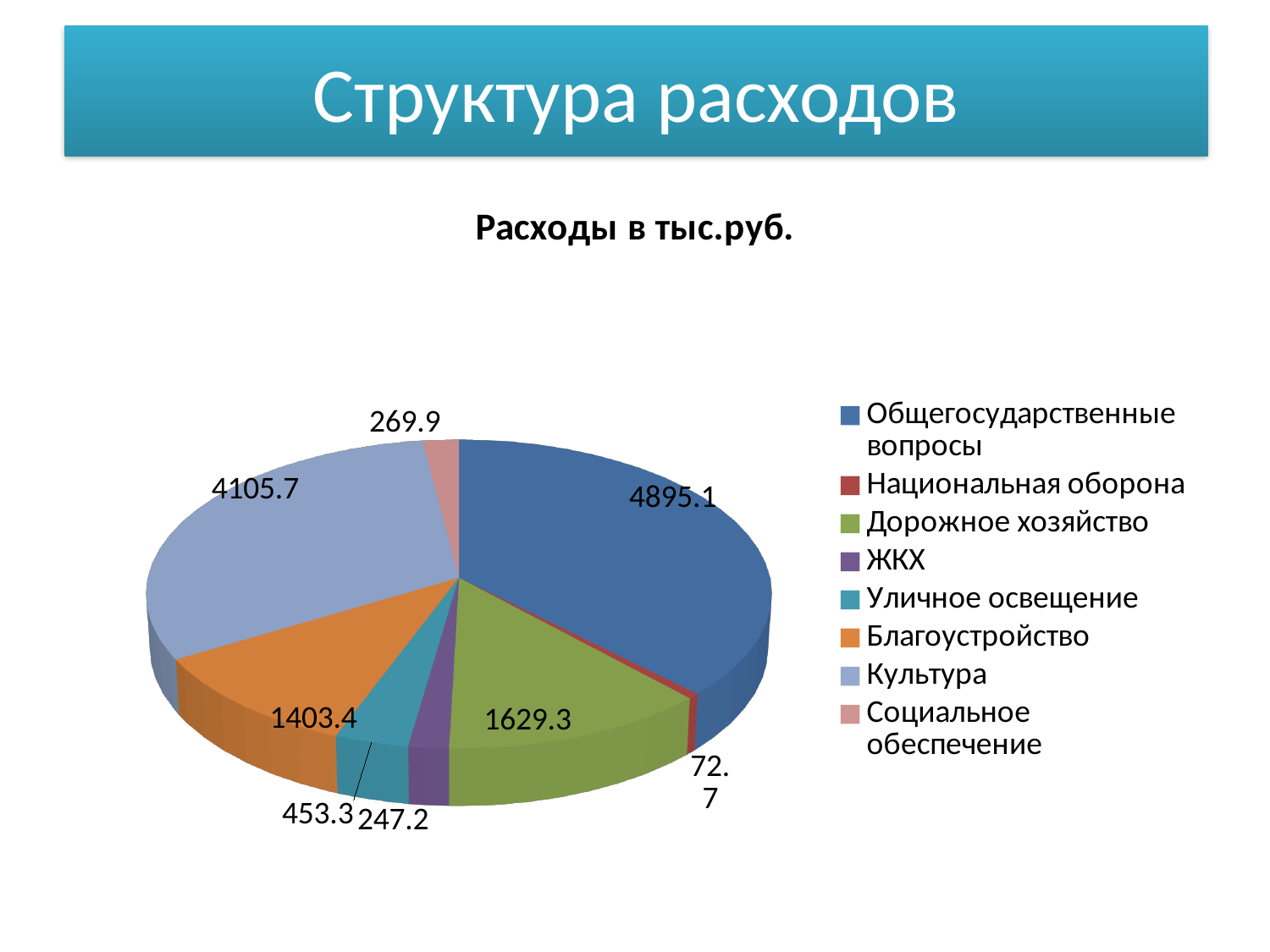
What is the value for Общегосударственные вопросы? 4895.1 What is the value for Культура? 4105.7 What is the value for Национальная оборона? 72.7 What is the difference between the values for Общегосударственные вопросы and Культура? 789.4 What is the value for Благоустройство? 1403.4 How many categories does the legend of the pie chart list? 8 Which category has the smallest value? Национальная оборона What type of chart is shown on the slide? Pie chart Which is larger, the value for Дорожное хозяйство or the value for Благоустройство? Дорожное хозяйство What is the title of the chart? Расходы в тыс.руб. What colour is the slice for Культура? Light blue Which category has the largest value? Общегосударственные вопросы